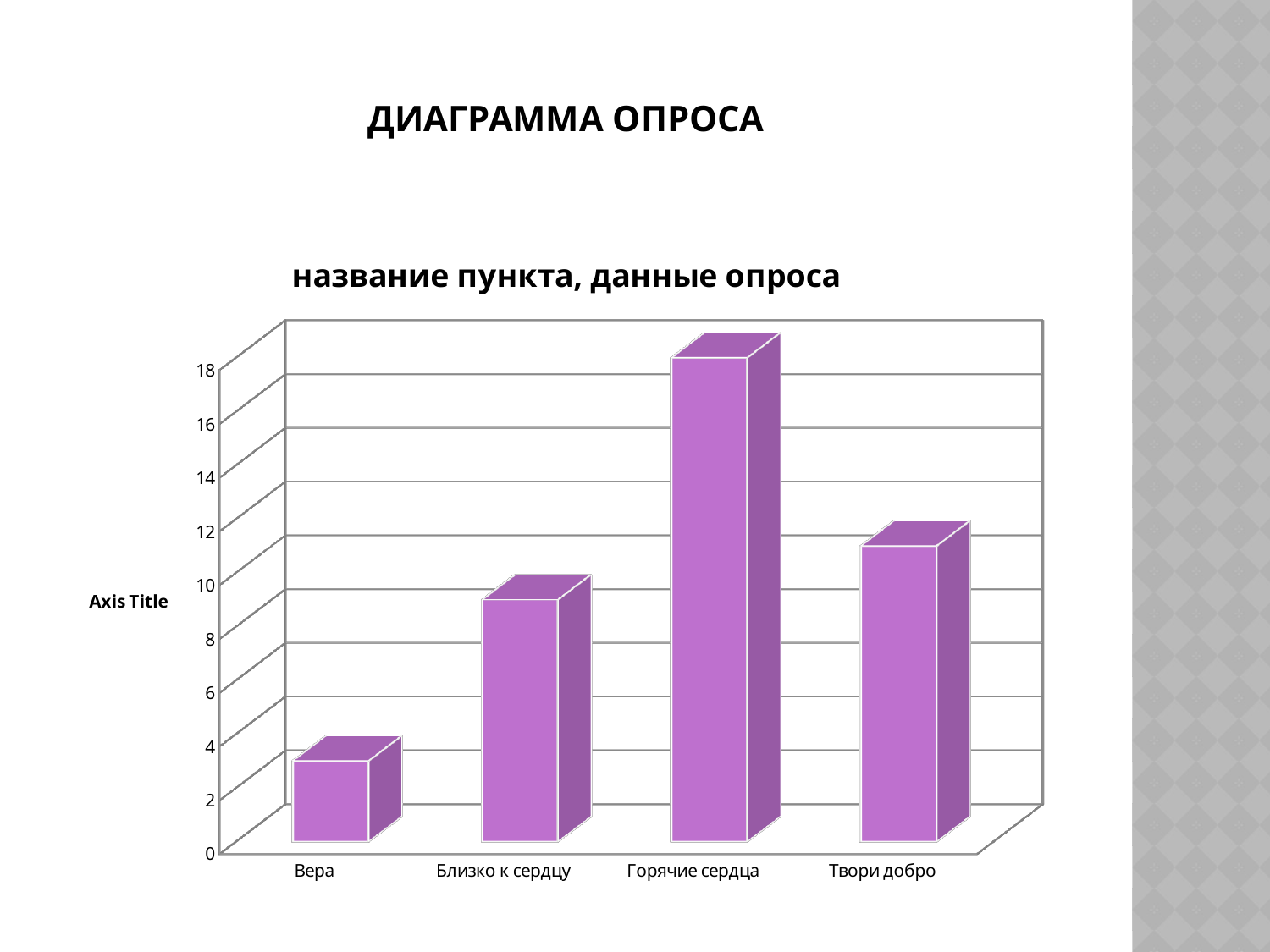
Which category has the highest bar in the chart? Горячие сердца Which is larger, the value for Близко к сердцу or the value for Твори добро? Твори добро Is the value for Горячие сердца greater or less than 16? greater Which category has the lowest bar in the chart? Вера How many categories are shown on the x axis of the chart? 4 What kind of chart is shown on the slide? bar chart Is the value for Близко к сердцу greater or less than 8? greater What is the label shown on the vertical axis of the chart? Axis Title Is the value for Вера greater or less than 4? less Which is larger, the value for Вера or the value for Близко к сердцу? Близко к сердцу What is the title of the chart? название пункта, данные опроса